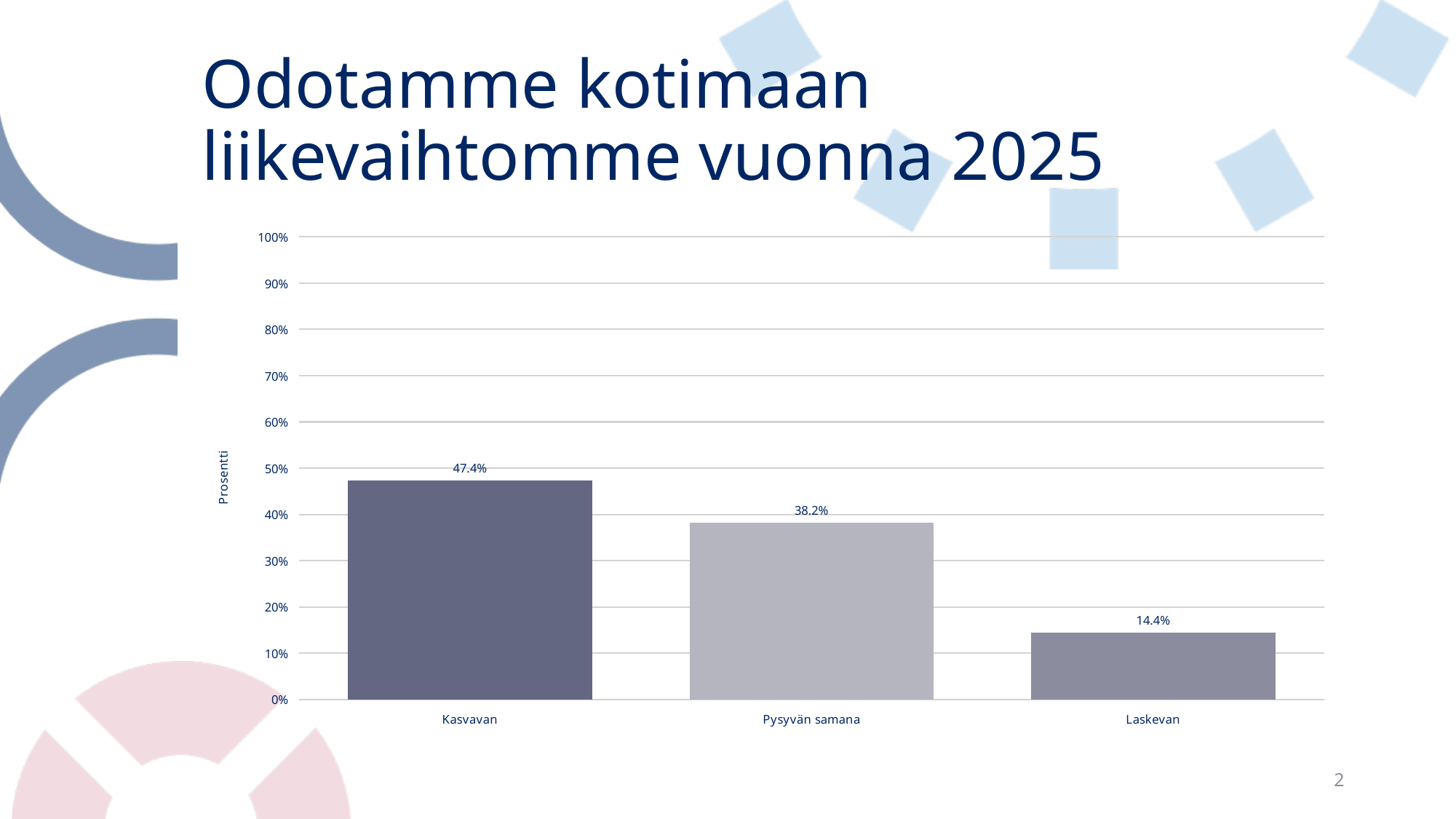
How many categories are shown on the x axis? 3 What is the value for Pysyvän samana? 38.2% Which category has the lowest value? Laskevan What is the difference between the values for Kasvavan and Pysyvän samana? 9.2% Which category has the highest value? Kasvavan Is the value for Pysyvän samana greater or less than 40%? less What is the value for Laskevan? 14.4% What is the difference between the values for Pysyvän samana and Laskevan? 23.8% Which is larger, the value for Kasvavan or the value for Laskevan? Kasvavan What is the value for Kasvavan? 47.4% What is the label of the y axis? Prosentti What kind of chart is shown on the slide? bar chart